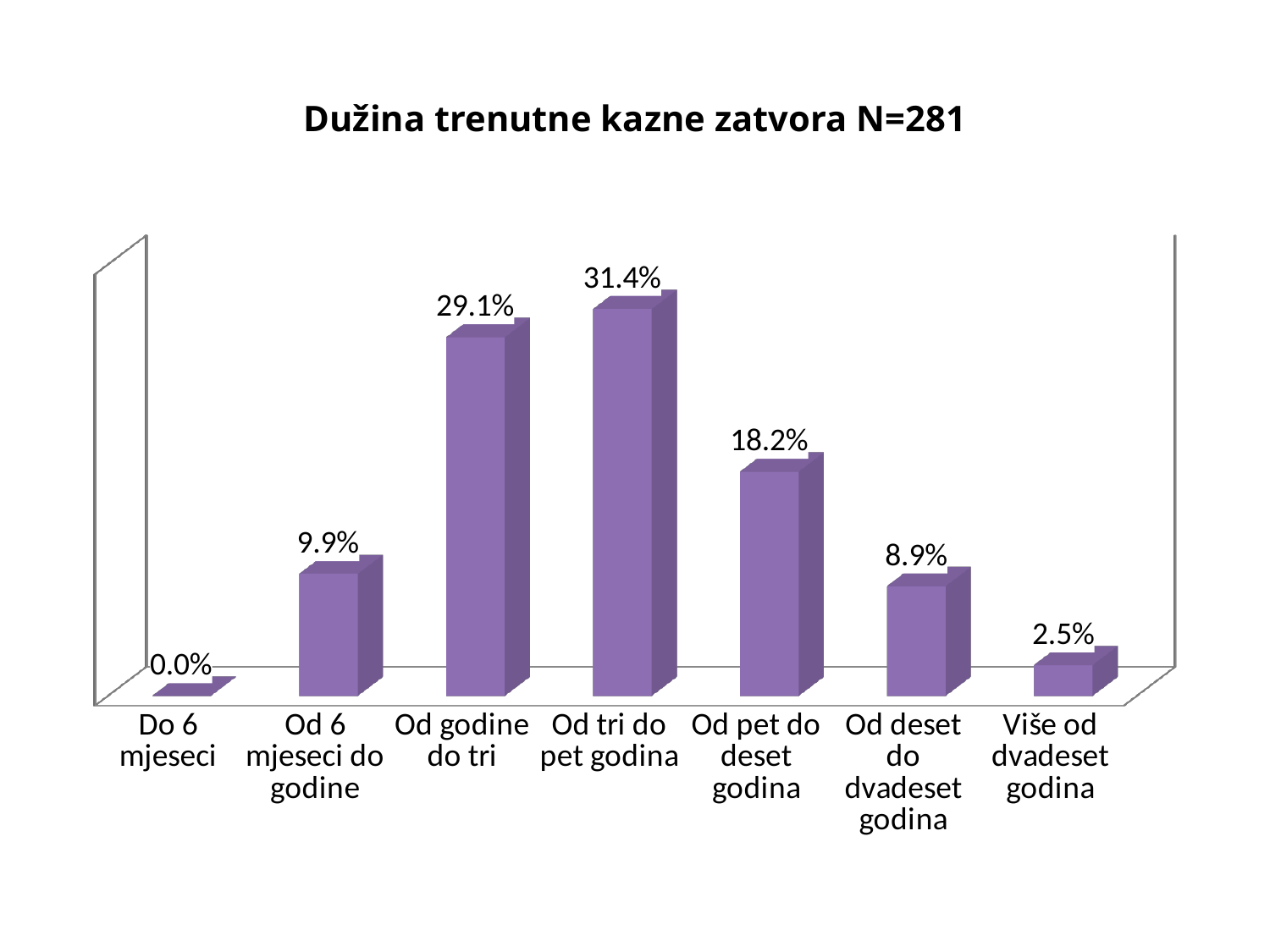
What kind of chart is this? bar chart What is the title of the chart? Dužina trenutne kazne zatvora N=281 How many categories are shown on the x axis? 7 Which is larger, the value for "Od pet do deset godina" or the value for "Od 6 mjeseci do godine"? Od pet do deset godina Which category has the lowest value? Do 6 mjeseci Which category has the highest value? Od tri do pet godina What is the value for "Više od dvadeset godina"? 2.5% What is the difference between the values for "Od pet do deset godina" and "Od deset do dvadeset godina"? 9.3% What is the value for "Od 6 mjeseci do godine"? 9.9% What is the value for "Od tri do pet godina"? 31.4% What is the value for "Od deset do dvadeset godina"? 8.9% What is the difference between the values for "Od tri do pet godina" and "Od godine do tri"? 2.3%